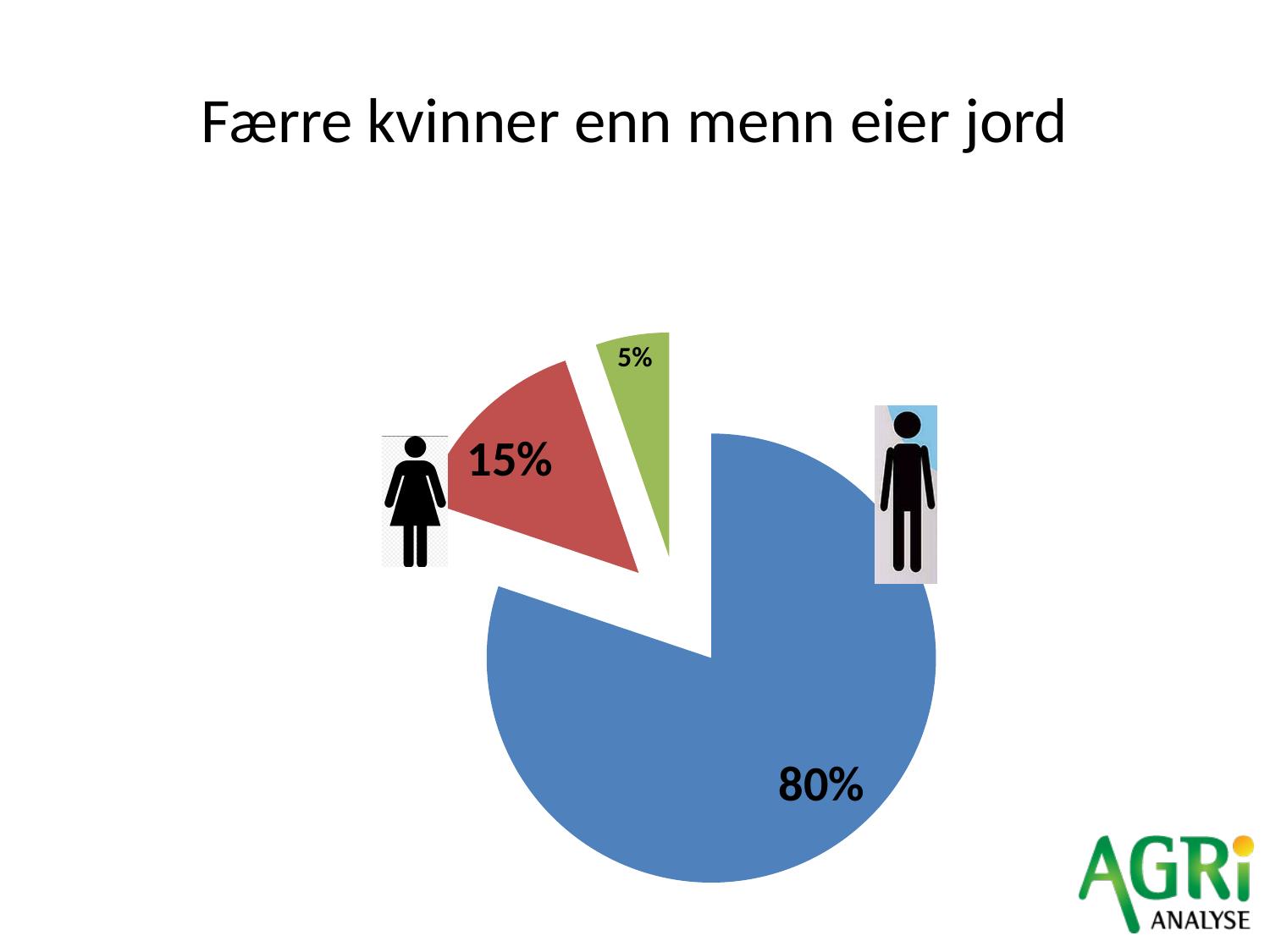
What share does the red slice of the pie chart represent? 15% How many slices does the pie chart have? 3 What is the difference in percentage points between the blue slice and the red slice? 65 What share does the blue slice of the pie chart represent? 80% Which slice of the pie chart is the smallest? the green slice (5%) Which slice of the pie chart is the largest? the blue slice (80%) What share does the green slice of the pie chart represent? 5% What is the difference in percentage points between the red slice and the green slice? 10 Which is larger, the red slice or the green slice? the red slice What share is shown next to the female figure icon? 15% What is the title of the slide? Færre kvinner enn menn eier jord What kind of chart is shown on the slide? pie chart